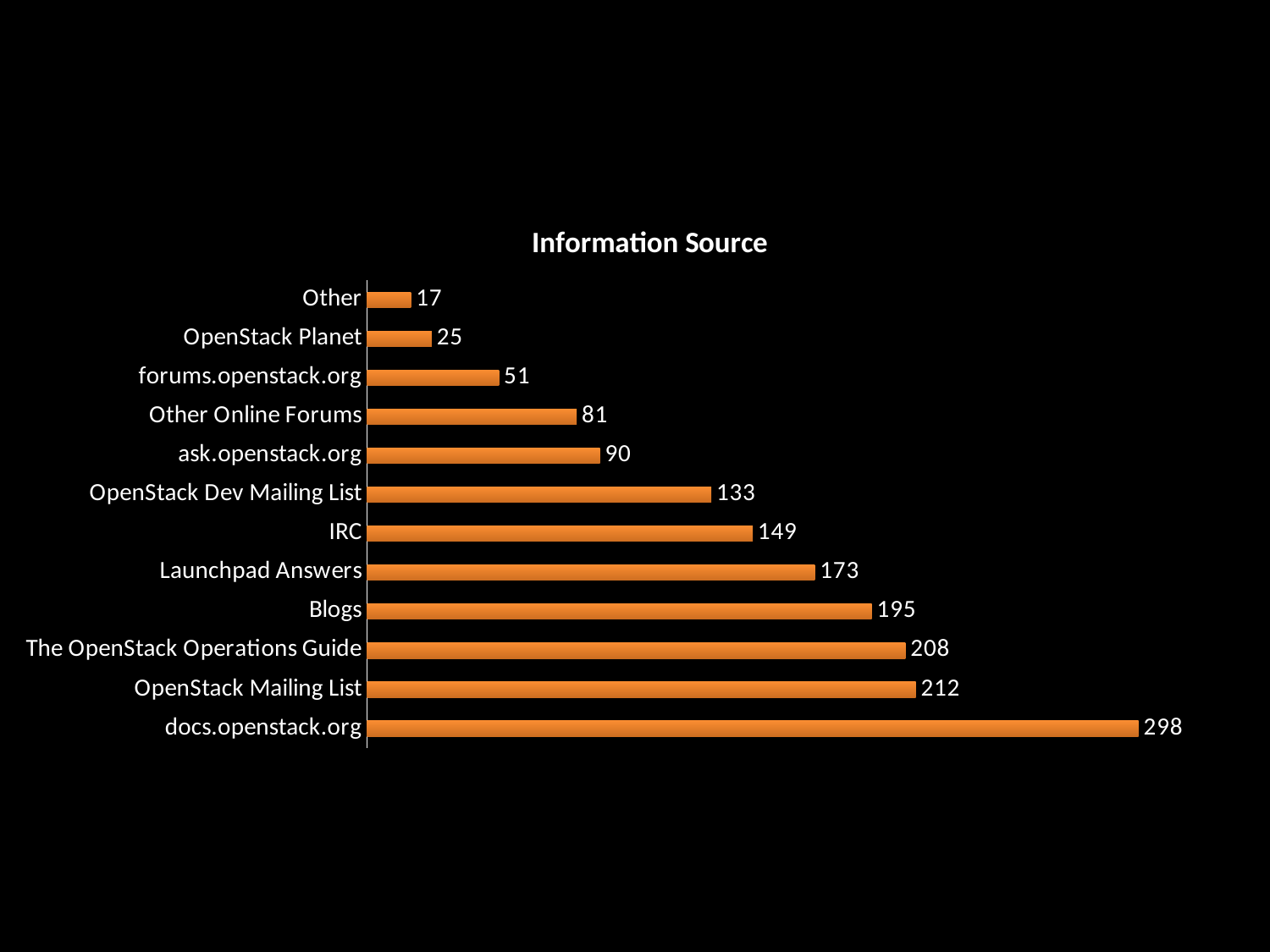
What is the value for IRC? 149 Which information source has the highest value? docs.openstack.org What is the difference between the values for docs.openstack.org and Blogs? 103 What is the title of the chart? Information Source Which information source has the lowest value? Other What kind of chart is shown on the slide? Bar chart Which is larger, the value for Launchpad Answers or the value for OpenStack Dev Mailing List? Launchpad Answers How many information sources are shown in the chart? 12 What is the value for ask.openstack.org? 90 What is the difference between the values for OpenStack Mailing List and The OpenStack Operations Guide? 4 What is the value for forums.openstack.org? 51 What is the value for docs.openstack.org? 298